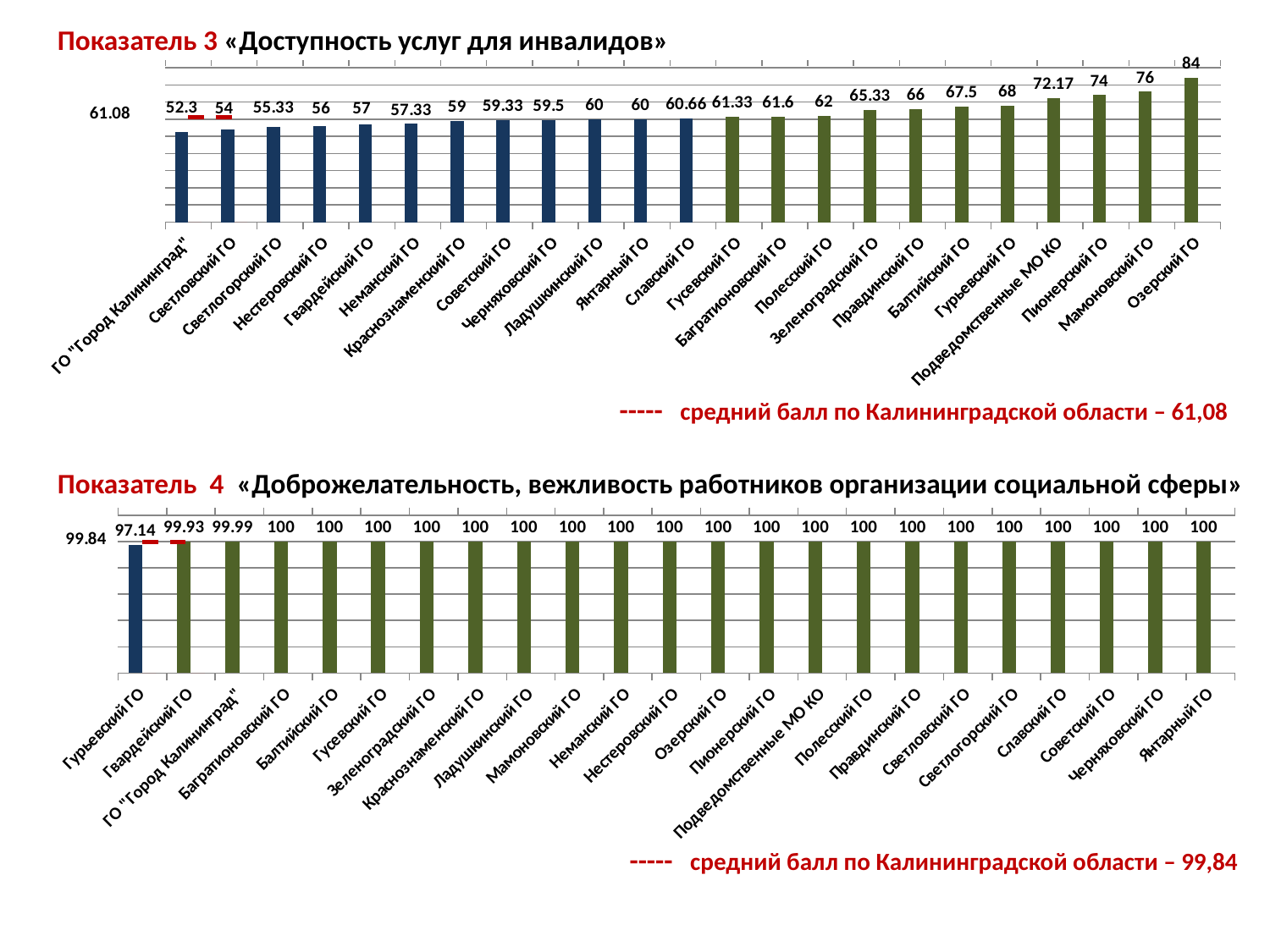
In the bottom chart (Показатель 4), what is the value for Гурьевский ГО? 97.14 In the top chart (Показатель 3), which is larger: the value for Пионерский ГО or the value for Балтийский ГО? Пионерский ГО In the top chart (Показатель 3), what is the value for Подведомственные МО КО? 72.17 What is the average score for the Kaliningrad region shown for Показатель 3? 61,08 In the top chart (Показатель 3), do the values rise or fall from left to right? rise In the top chart (Показатель 3), how many categories are plotted? 23 What type of chart is the bottom chart (Показатель 4)? bar chart In the top chart (Показатель 3), which category has the lowest value? ГО "Город Калининград" In the top chart (Показатель 3 «Доступность услуг для инвалидов»), what is the value for Озерский ГО? 84 In the bottom chart (Показатель 4), what is the value for Гвардейский ГО? 99.93 In the top chart (Показатель 3), which category has the highest value? Озерский ГО In the top chart (Показатель 3), what is the difference between the values for Озерский ГО and ГО "Город Калининград"? 31.7